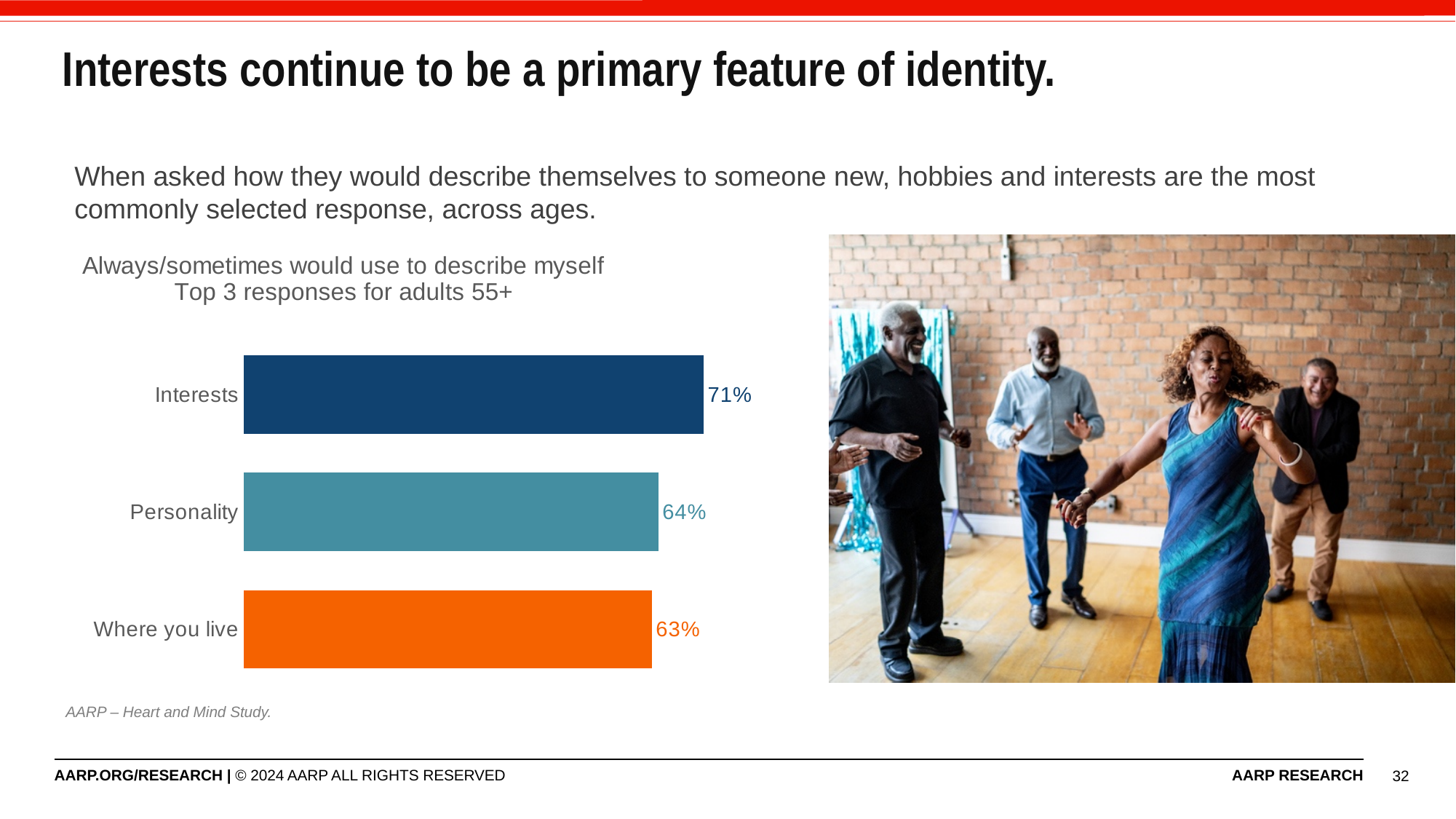
What is the title of the chart? Always/sometimes would use to describe myself Top 3 responses for adults 55+ Which is larger, the value for Interests or the value for Where you live? Interests What is the value shown for Personality? 64% How many responses are shown in the chart? 3 What kind of chart is shown on the slide? Bar chart Which response has the highest percentage? Interests Which response has the lowest percentage? Where you live What percentage of adults 55+ would always/sometimes use Interests to describe themselves? 71% What is the value shown for Where you live? 63% What colour is the bar for Where you live? Orange What is the difference in percentage points between Interests and Personality? 7 percentage points What is the difference in percentage points between Interests and Where you live? 8 percentage points